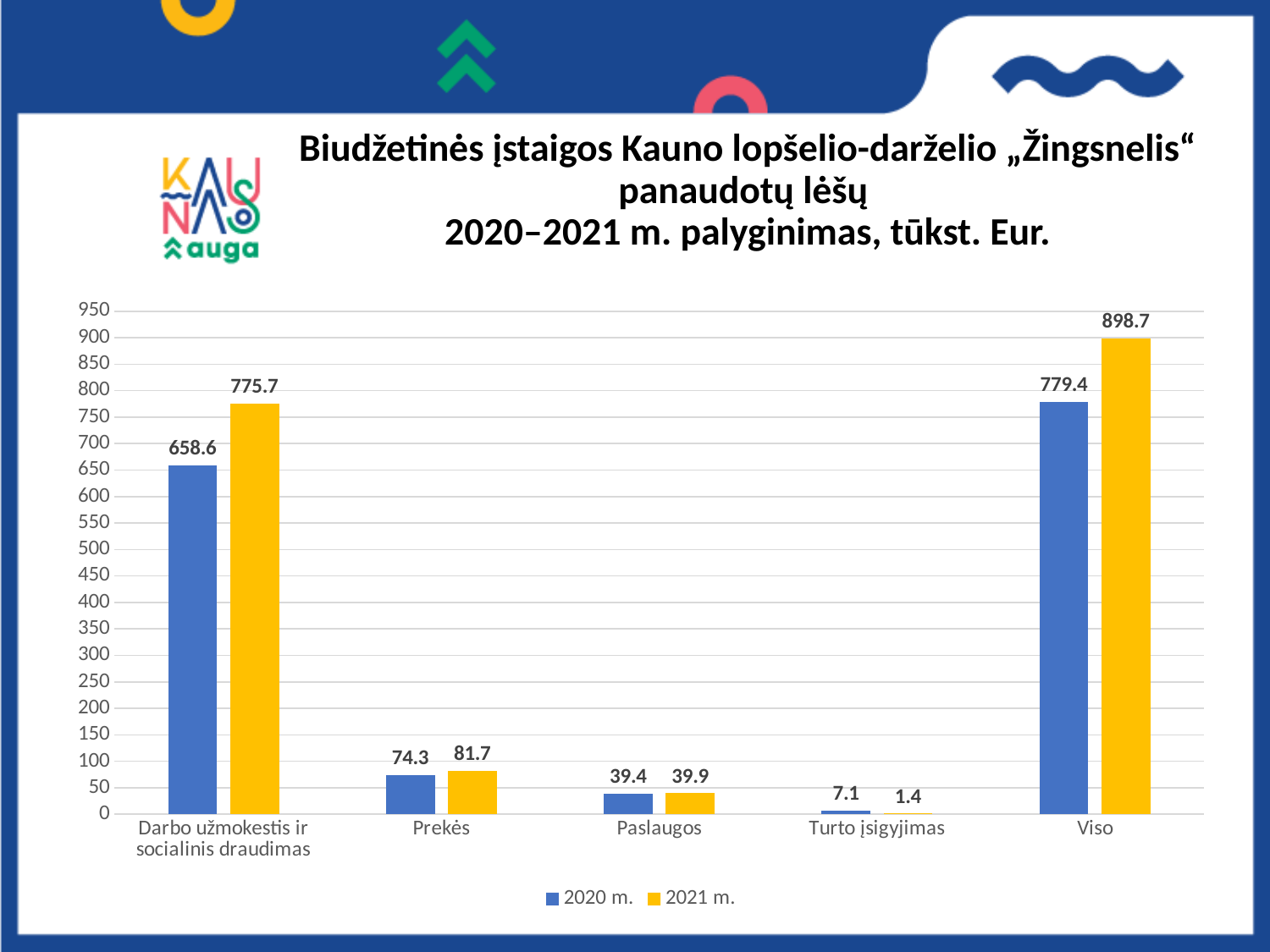
Which colour represents 2021 m. in the chart? Yellow What is the value for Darbo užmokestis ir socialinis draudimas in 2020 m.? 658.6 Which category has the highest value in 2021 m.? Viso How many categories are shown on the x axis? 5 What is the value for Turto įsigyjimas in 2021 m.? 1.4 Which is larger for Turto įsigyjimas: the 2020 m. value or the 2021 m. value? 2020 m. How many series does the legend list? 2 What is the value for Prekės in 2020 m.? 74.3 What is the difference between the 2021 m. and 2020 m. values for Viso? 119.3 Which category has the lowest value in 2020 m.? Turto įsigyjimas What kind of chart is shown on the slide? Bar chart What is the value for Viso in 2021 m.? 898.7